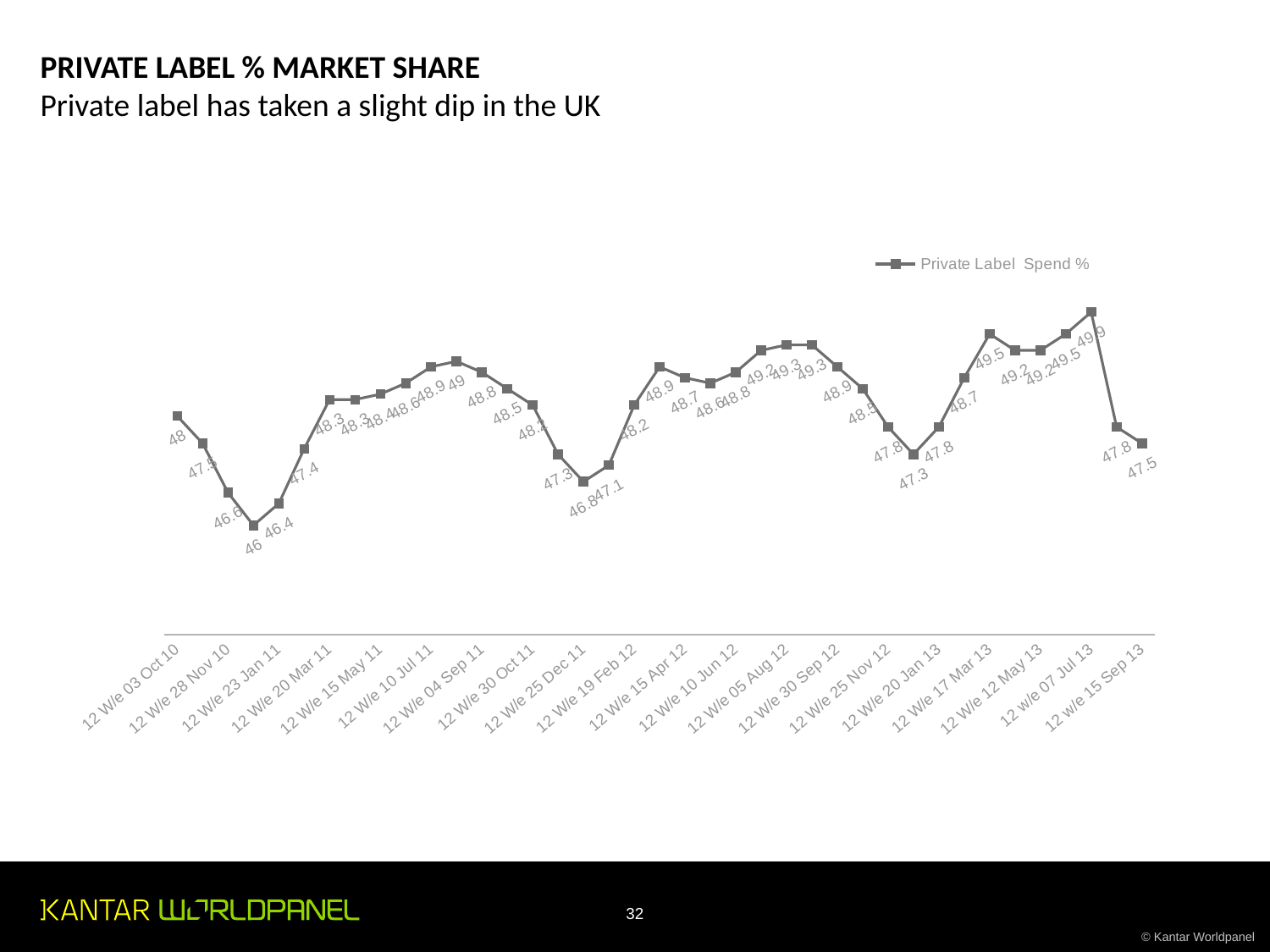
What is the difference between the Private Label Spend % for 12 W/e 03 Oct 10 and 12 W/e 28 Nov 10? 1.4 What is the lowest Private Label Spend % value plotted on the chart? 46 What is the highest Private Label Spend % value plotted on the chart? 49.9 Does the Private Label Spend % rise or fall between 12 w/e 07 Jul 13 and 12 w/e 15 Sep 13? fall What is the difference between the Private Label Spend % for 12 w/e 07 Jul 13 and 12 w/e 15 Sep 13? 2.4 What is the Private Label Spend % value for 12 W/e 25 Dec 11? 46.8 What is the Private Label Spend % value for 12 W/e 03 Oct 10? 48 What series name is shown in the chart legend? Private Label Spend % What is the Private Label Spend % value for 12 w/e 15 Sep 13? 47.5 What kind of chart is shown on the slide? line chart Which has the higher Private Label Spend %, 12 W/e 17 Mar 13 or 12 W/e 12 May 13? 12 W/e 17 Mar 13 How many series does the legend list? 1